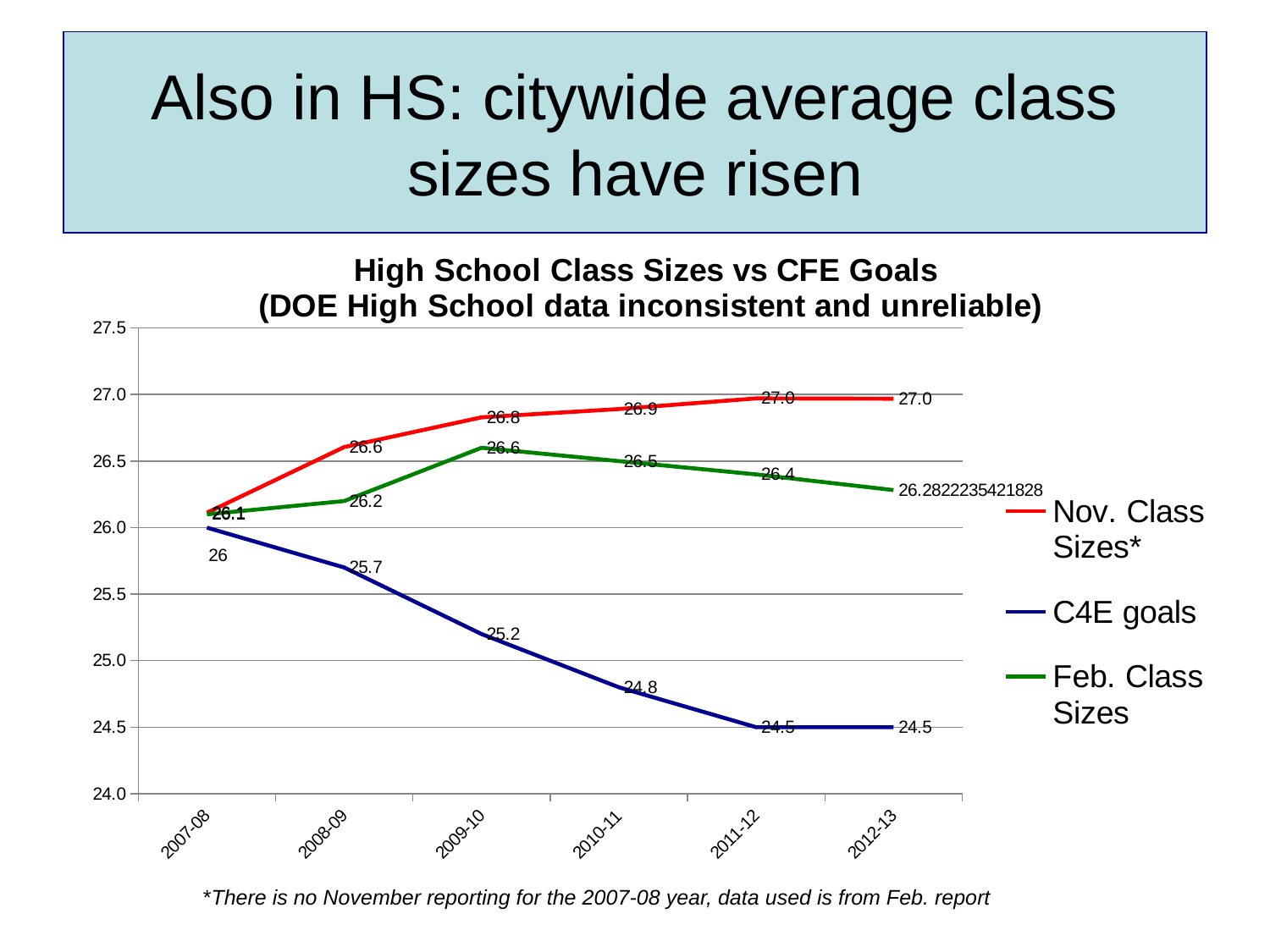
Is the C4E goals value for 2009-10 greater or less than 25.0? greater What is the difference between the Nov. Class Sizes value and the C4E goals value in 2012-13? 2.5 What is the Nov. Class Sizes value for 2011-12? 27.0 What is the Feb. Class Sizes value for 2009-10? 26.6 How many school years are shown on the x axis? 6 How many series does the legend list? 3 In which school year is the Feb. Class Sizes value lowest? 2007-08 What is the difference between the Nov. Class Sizes value and the C4E goals value in 2008-09? 0.9 What kind of chart is shown on the slide? line chart What is the C4E goals value for 2010-11? 24.8 In which school year is the C4E goals value highest? 2007-08 In 2010-11, which is larger: Nov. Class Sizes or Feb. Class Sizes? Nov. Class Sizes